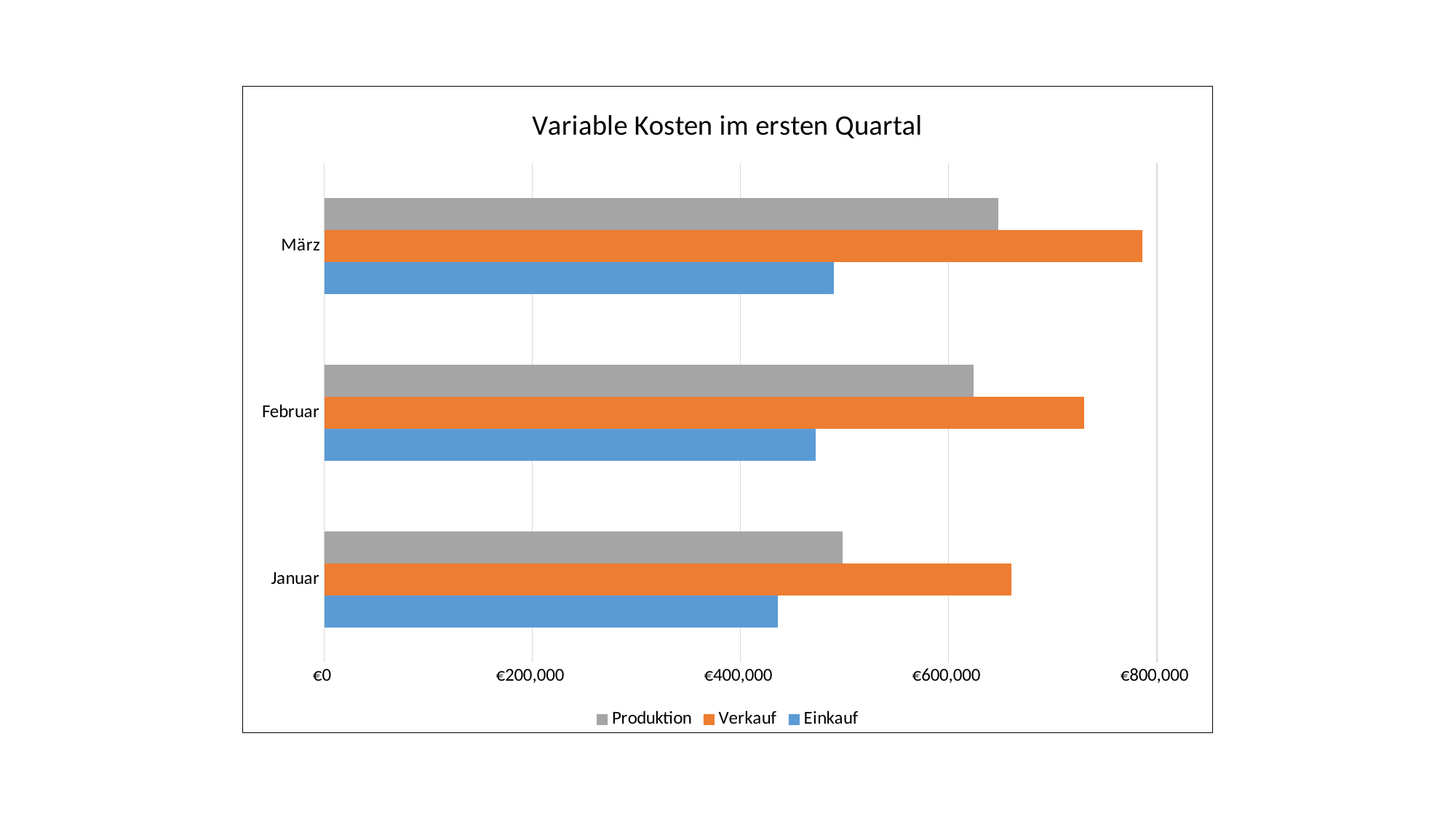
Which series has the lowest value in Januar? Einkauf In which month is the Einkauf value lowest? Januar How many months (categories) are shown on the chart? 3 Which series is shown in orange? Verkauf Is the Verkauf value for März greater or less than €600,000? greater Is the Einkauf value for Januar greater or less than €600,000? less Does the Verkauf value rise or fall from Januar to März? rise Which series has the highest value in März? Verkauf How many series does the legend list? 3 What is the title of the chart? Variable Kosten im ersten Quartal In which month is the Verkauf value highest? März What type of chart is shown on the slide? bar chart